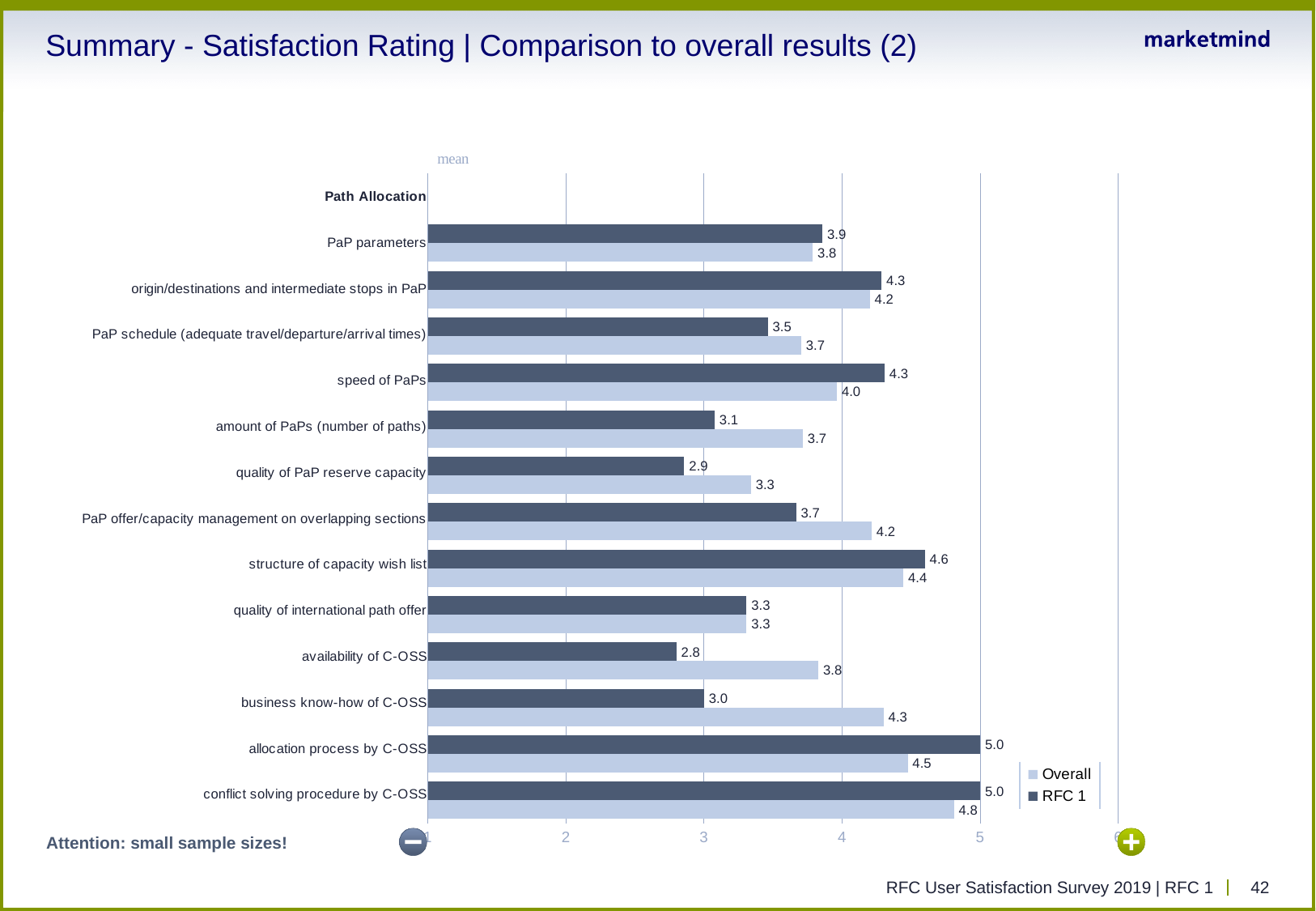
What is the Overall value for 'conflict solving procedure by C-OSS'? 4.8 Is the RFC 1 value for 'allocation process by C-OSS' greater or less than 4? greater How many series does the legend list? 2 Which category has the lowest RFC 1 value? availability of C-OSS What kind of chart is shown on the slide? bar chart What is the RFC 1 value for 'availability of C-OSS'? 2.8 Which category has the highest Overall value? conflict solving procedure by C-OSS What is the difference between the Overall and RFC 1 values for 'business know-how of C-OSS'? 1.3 How many categories are plotted in the chart? 13 What is the Overall value for 'business know-how of C-OSS'? 4.3 Which is larger for 'speed of PaPs', the RFC 1 value or the Overall value? RFC 1 What is the RFC 1 value for 'structure of capacity wish list'? 4.6